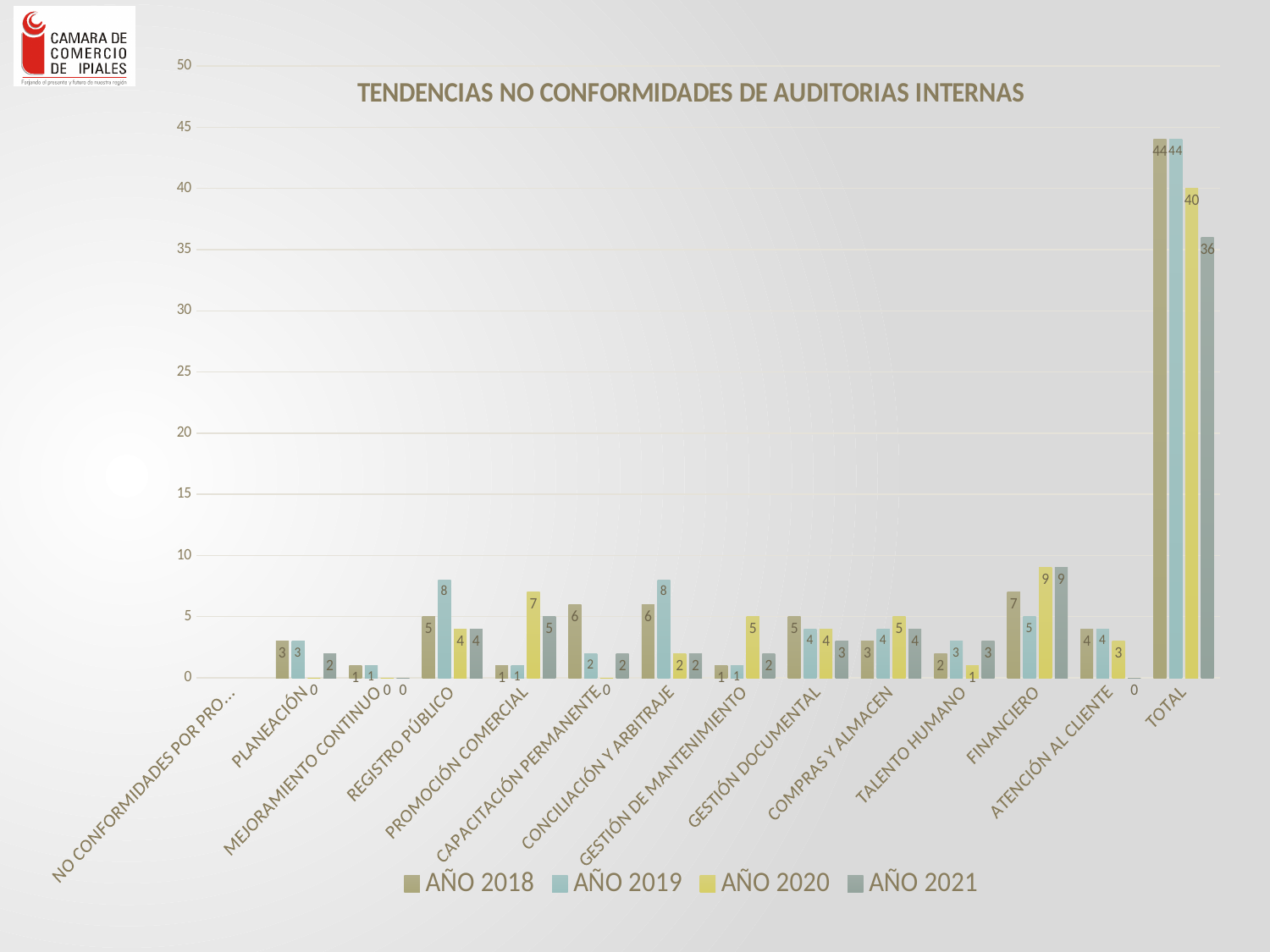
What is the title of the chart? TENDENCIAS NO CONFORMIDADES DE AUDITORIAS INTERNAS What is the value for AÑO 2020 in the PROMOCIÓN COMERCIAL category? 7 Which year has the lowest TOTAL value? AÑO 2021 What type of chart is shown on the slide? bar chart Excluding TOTAL, which category has the highest value for AÑO 2020? FINANCIERO What is the value for AÑO 2019 in the REGISTRO PÚBLICO category? 8 What is the difference between the TOTAL values for AÑO 2018 and AÑO 2020? 4 What is the TOTAL value for AÑO 2021? 36 Is the TOTAL value for AÑO 2020 greater or less than 35? greater What is the value for AÑO 2018 in the FINANCIERO category? 7 How many series does the legend list? 4 Which is larger in the CONCILIACIÓN Y ARBITRAJE category: AÑO 2018 or AÑO 2019? AÑO 2019